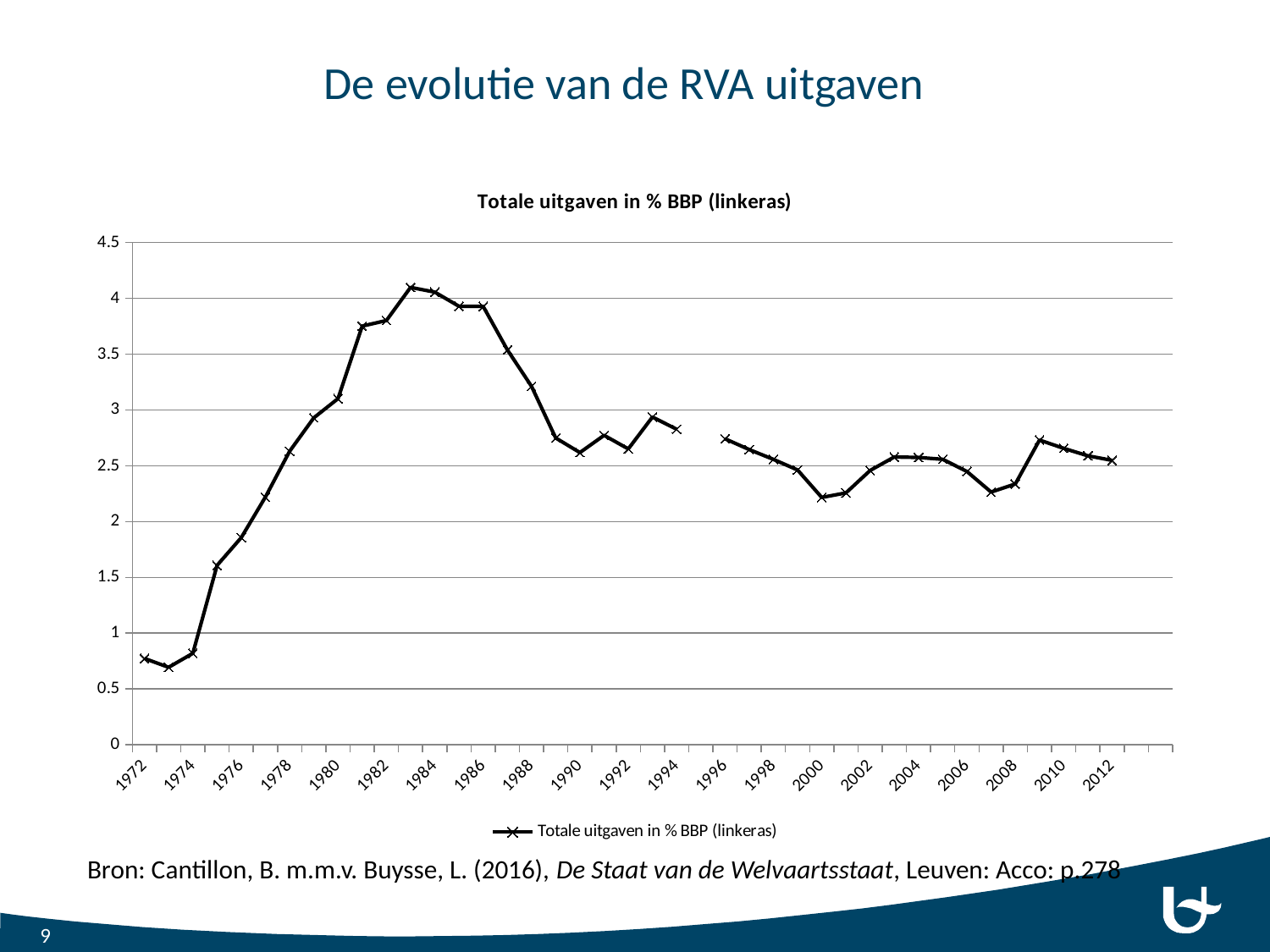
Which year has the larger value, 1972 or 2012? 2012 Which year has the larger value, 1984 or 1994? 1984 Is the value for 1986 greater or less than 3.5? greater In which year does the line reach its lowest value? 1973 Is the value for 1983 greater or less than 4? greater Do the values rise or fall between 1972 and 1983? rise Is the value for 1990 greater or less than 3? less What kind of chart is shown on the slide? line chart In which year does the line reach its highest value? 1983 How many series does the legend list? 1 What is the title of the chart? Totale uitgaven in % BBP (linkeras)